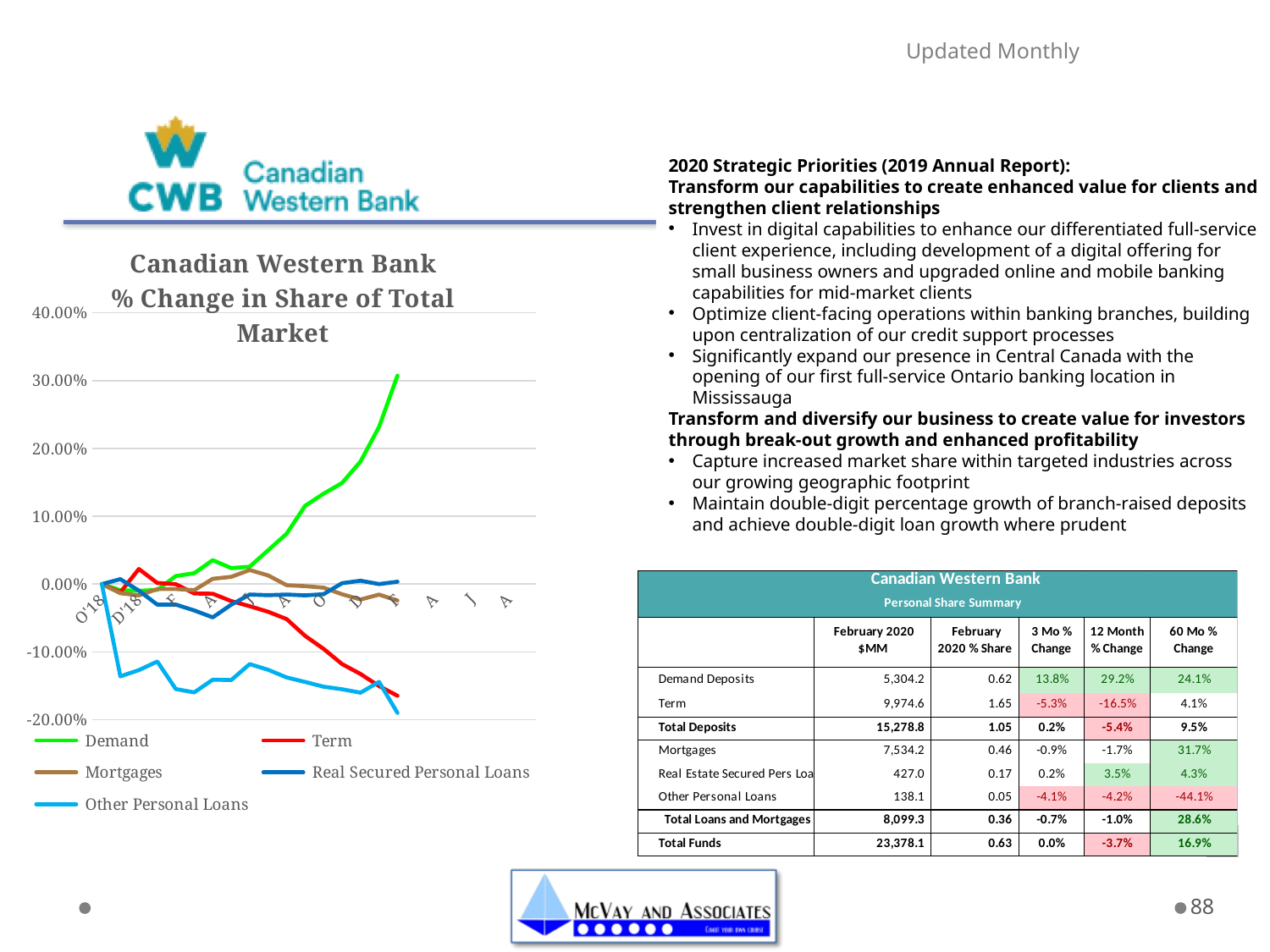
What is the title of the chart? Canadian Western Bank % Change in Share of Total Market Is the value for Other Personal Loans at D'18 greater or less than -10.00%? less Is the final value of the Term series greater or less than -10.00%? less At the end of the period, is the value for Demand or for Mortgages larger? Demand Which colour is used for the Demand series in the chart? Green Does the Term series rise or fall over the period shown on the x axis? Fall Is the final value of the Demand series greater or less than 20.00%? greater What is the highest value shown on the chart's vertical axis? 40.00% What kind of chart is shown on the slide? Line chart Does the Demand series rise or fall over the period shown on the x axis? Rise Which series reaches the highest value at the end of the period shown? Demand How many series does the legend of the chart list? 5